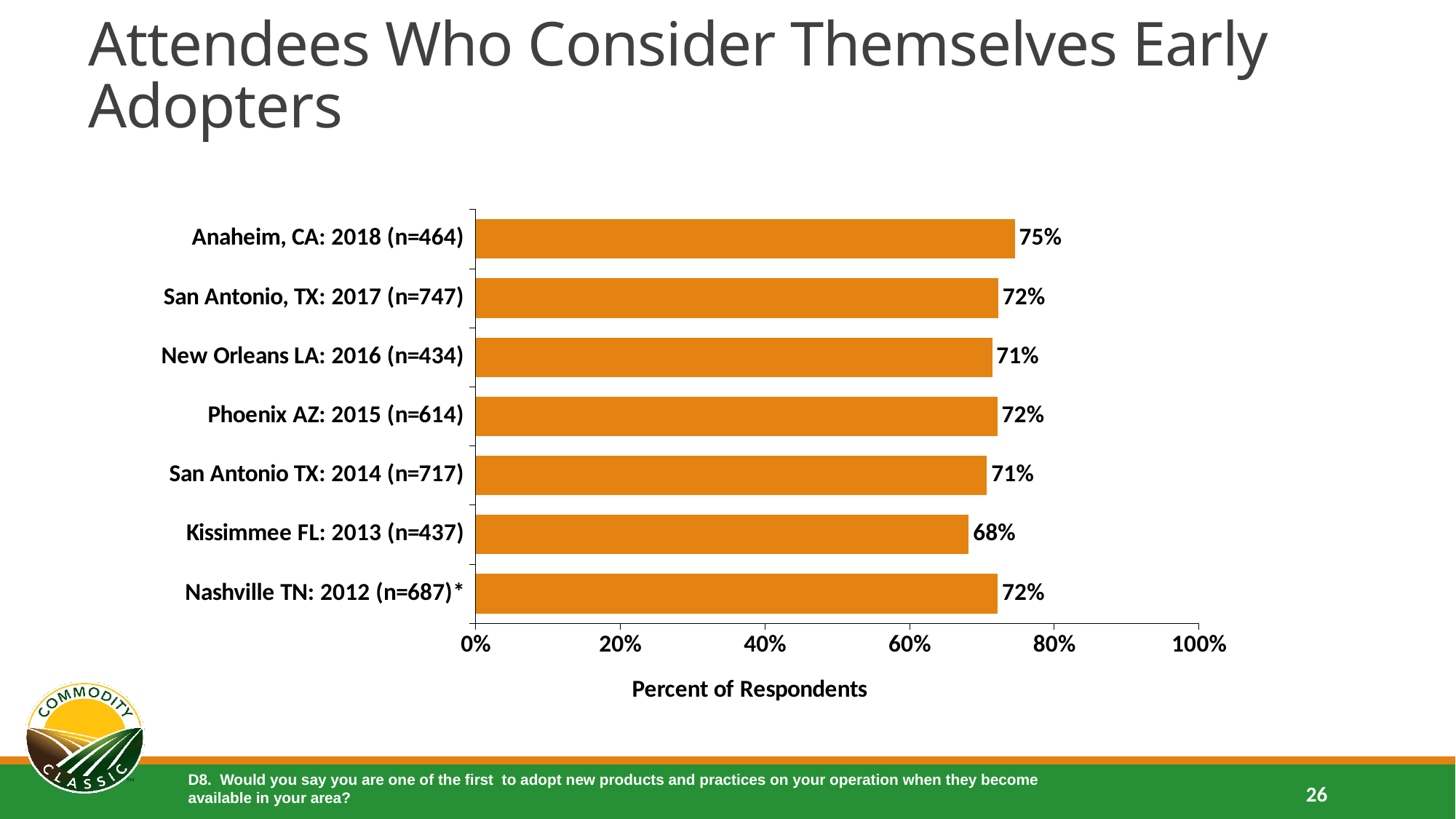
What kind of chart is shown on the slide? Bar chart What is the difference between the values for Anaheim, CA: 2018 and Kissimmee FL: 2013? 7% How many categories are shown in the chart? 7 Is the value for Phoenix AZ: 2015 (n=614) greater or less than 60%? greater What is the label of the horizontal axis? Percent of Respondents What is the value for Nashville TN: 2012 (n=687)*? 72% Which is larger, the value for San Antonio, TX: 2017 (n=747) or the value for Kissimmee FL: 2013 (n=437)? San Antonio, TX: 2017 (n=747) What is the value for Kissimmee FL: 2013 (n=437)? 68% What percentage of attendees at Anaheim, CA: 2018 (n=464) consider themselves early adopters? 75% What is the value for New Orleans LA: 2016 (n=434)? 71% Which category has the lowest percentage of early adopters? Kissimmee FL: 2013 (n=437) Which category has the highest percentage of early adopters? Anaheim, CA: 2018 (n=464)